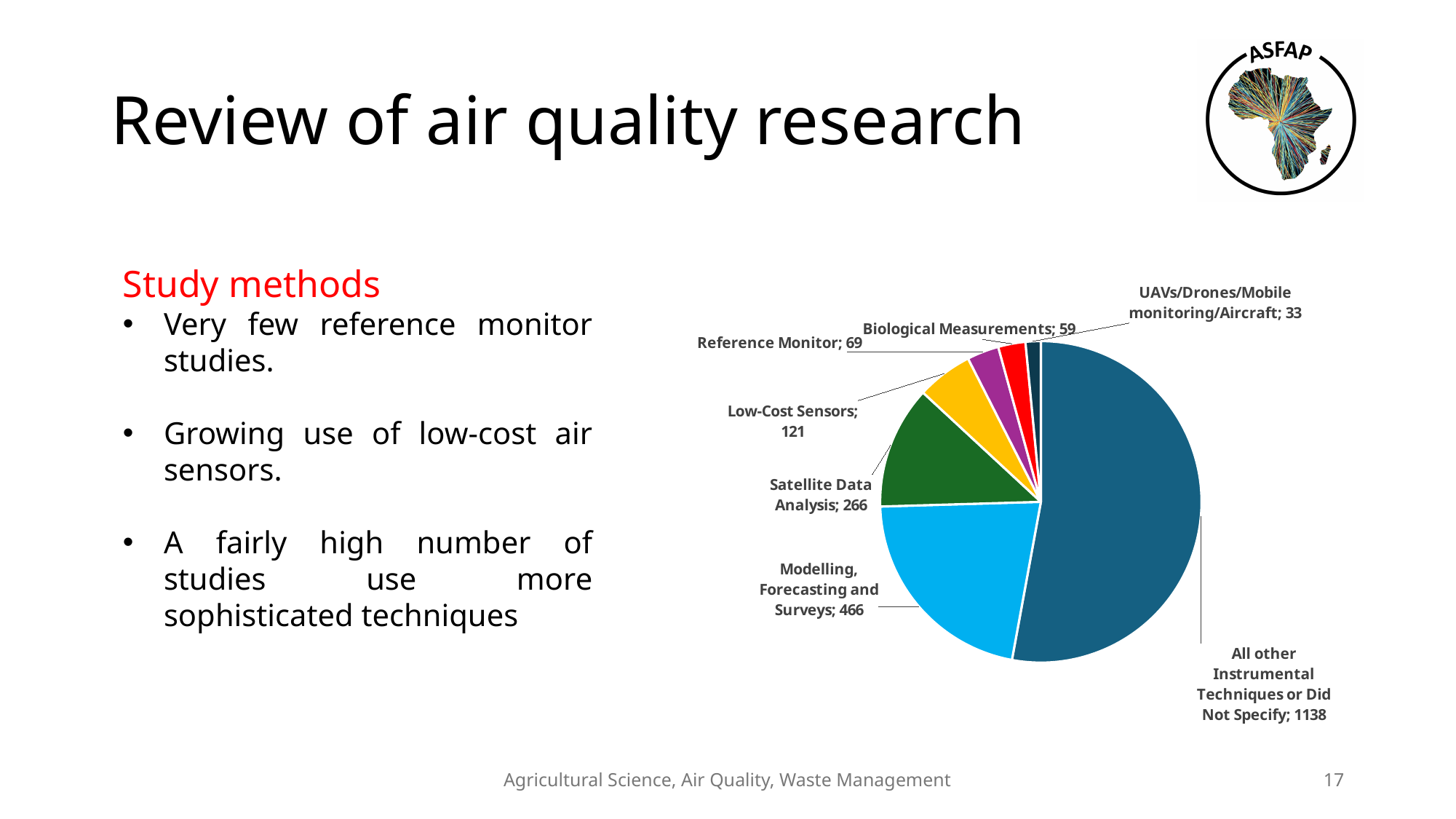
What is the value for Low-Cost Sensors in the pie chart? 121 What is the difference between the values for Modelling, Forecasting and Surveys and Satellite Data Analysis? 200 What is the value for UAVs/Drones/Mobile monitoring/Aircraft in the pie chart? 33 What is the value for Satellite Data Analysis in the pie chart? 266 Which category has the smallest slice in the pie chart? UAVs/Drones/Mobile monitoring/Aircraft What is the total of all the values shown in the pie chart? 2152 What kind of chart is shown on the slide? Pie chart What is the value for Reference Monitor in the pie chart? 69 Which is larger in the pie chart: Biological Measurements or Reference Monitor? Reference Monitor How many slices does the pie chart have? 7 What is the difference between the values for Low-Cost Sensors and Reference Monitor? 52 Which category has the largest slice in the pie chart? All other Instrumental Techniques or Did Not Specify